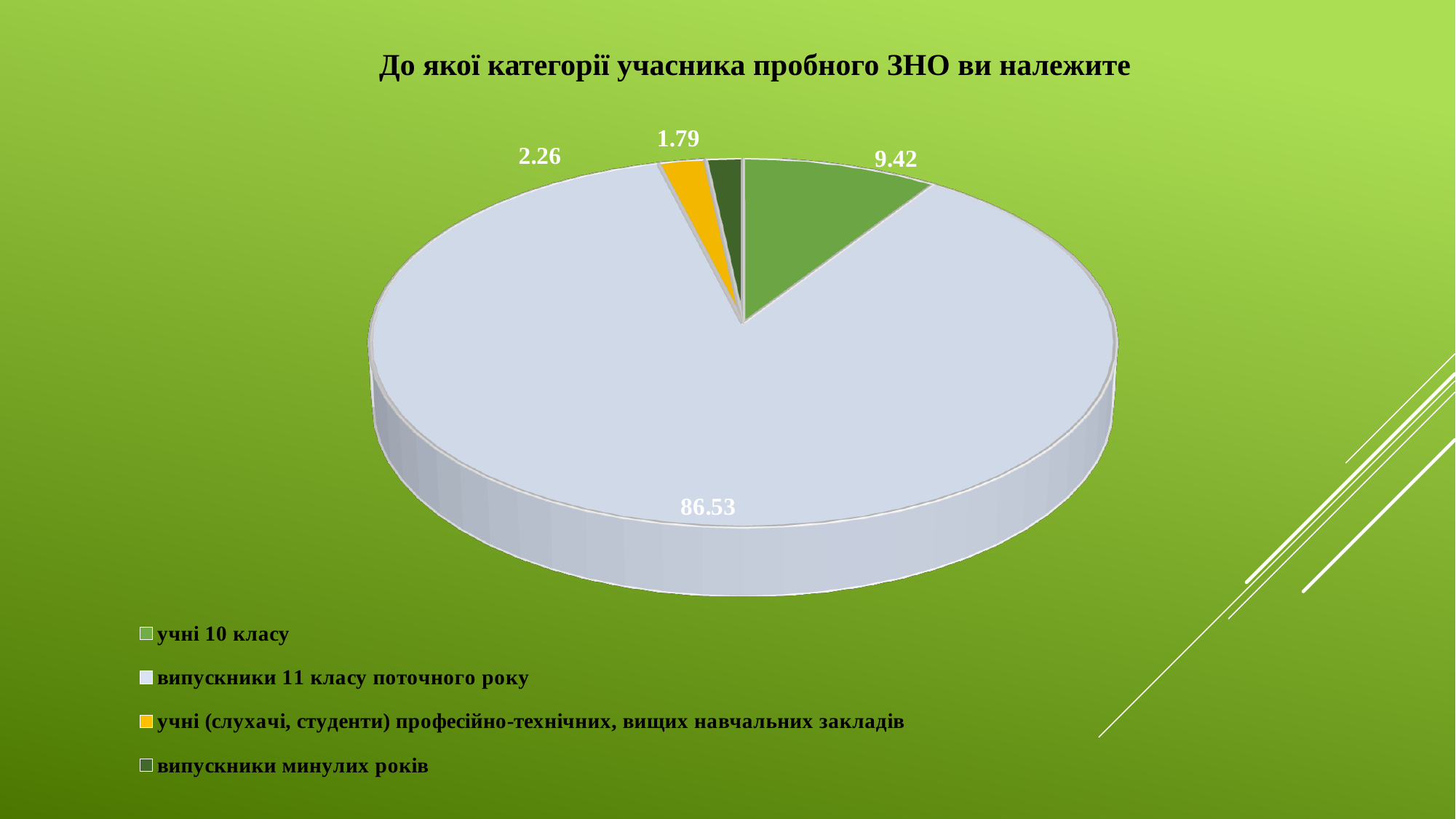
What is the difference between the values for "випускники 11 класу поточного року" and "учні 10 класу"? 77.11 Which is larger: the value for "учні 10 класу" or the value for "учні (слухачі, студенти) професійно-технічних, вищих навчальних закладів"? учні 10 класу What is the value for "учні (слухачі, студенти) професійно-технічних, вищих навчальних закладів"? 2.26 What is the value for "випускники 11 класу поточного року"? 86.53 What colour is the slice for "учні (слухачі, студенти) професійно-технічних, вищих навчальних закладів"? yellow How many categories does the pie chart show? 4 What is the value for "учні 10 класу"? 9.42 Which category has the largest slice of the pie? випускники 11 класу поточного року Which category has the smallest slice of the pie? випускники минулих років What is the value for "випускники минулих років"? 1.79 What is the title of the chart? До якої категорії учасника пробного ЗНО ви належите What kind of chart is shown on the slide? pie chart